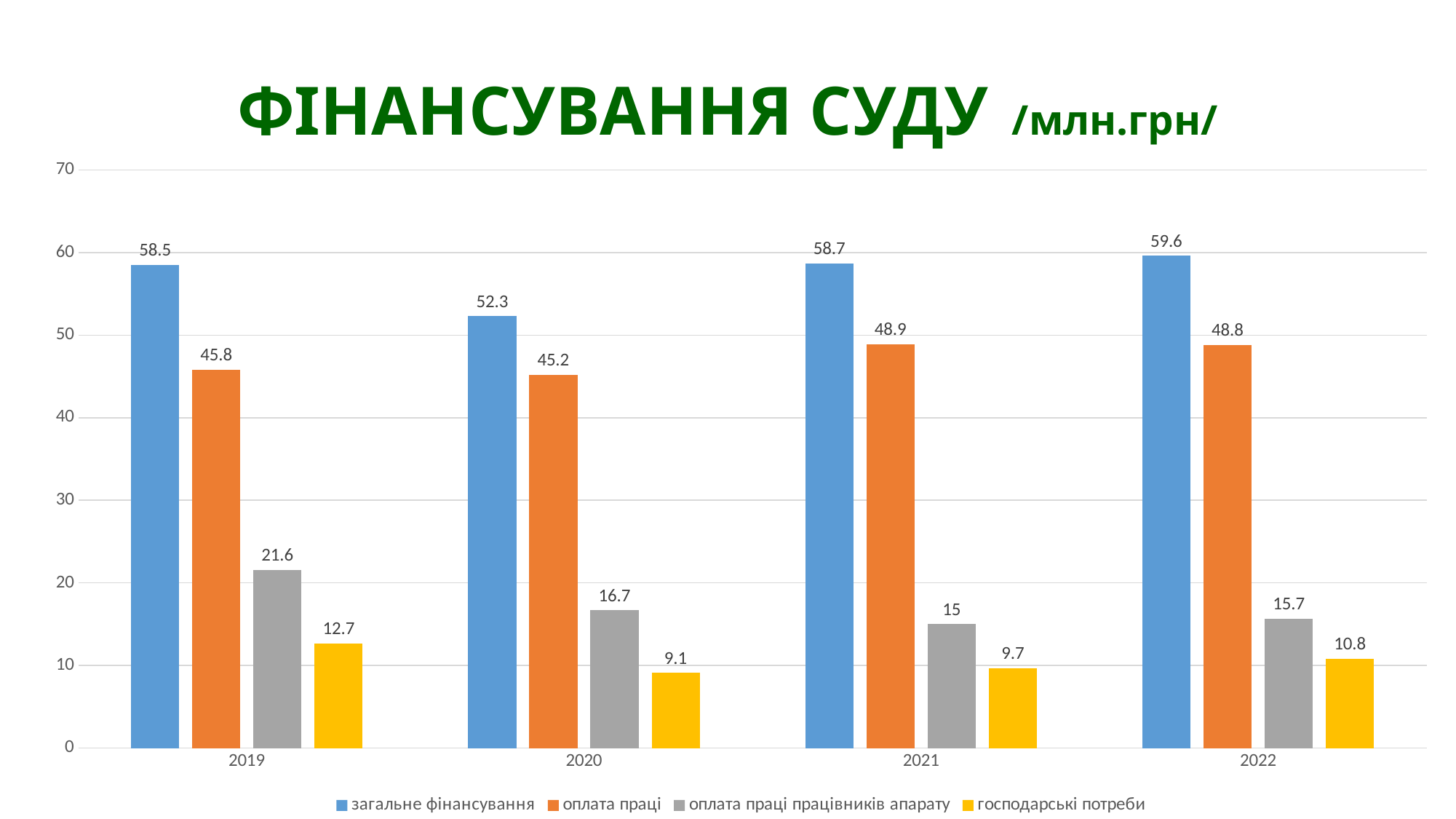
What is the value of оплата праці працівників апарату for 2021? 15 What is the value of загальне фінансування for 2020? 52.3 What is the difference between загальне фінансування and оплата праці in 2022? 10.8 How many years are shown on the x axis? 4 In which year is господарські потреби lowest? 2020 What is the title of the chart? ФІНАНСУВАННЯ СУДУ /млн.грн/ Is the value of оплата праці for 2021 greater or less than 40? greater What is the value of господарські потреби for 2019? 12.7 What kind of chart is shown on the slide? bar chart How many series does the legend list? 4 Which is larger: оплата праці працівників апарату in 2019 or in 2022? 2019 In which year is загальне фінансування highest? 2022